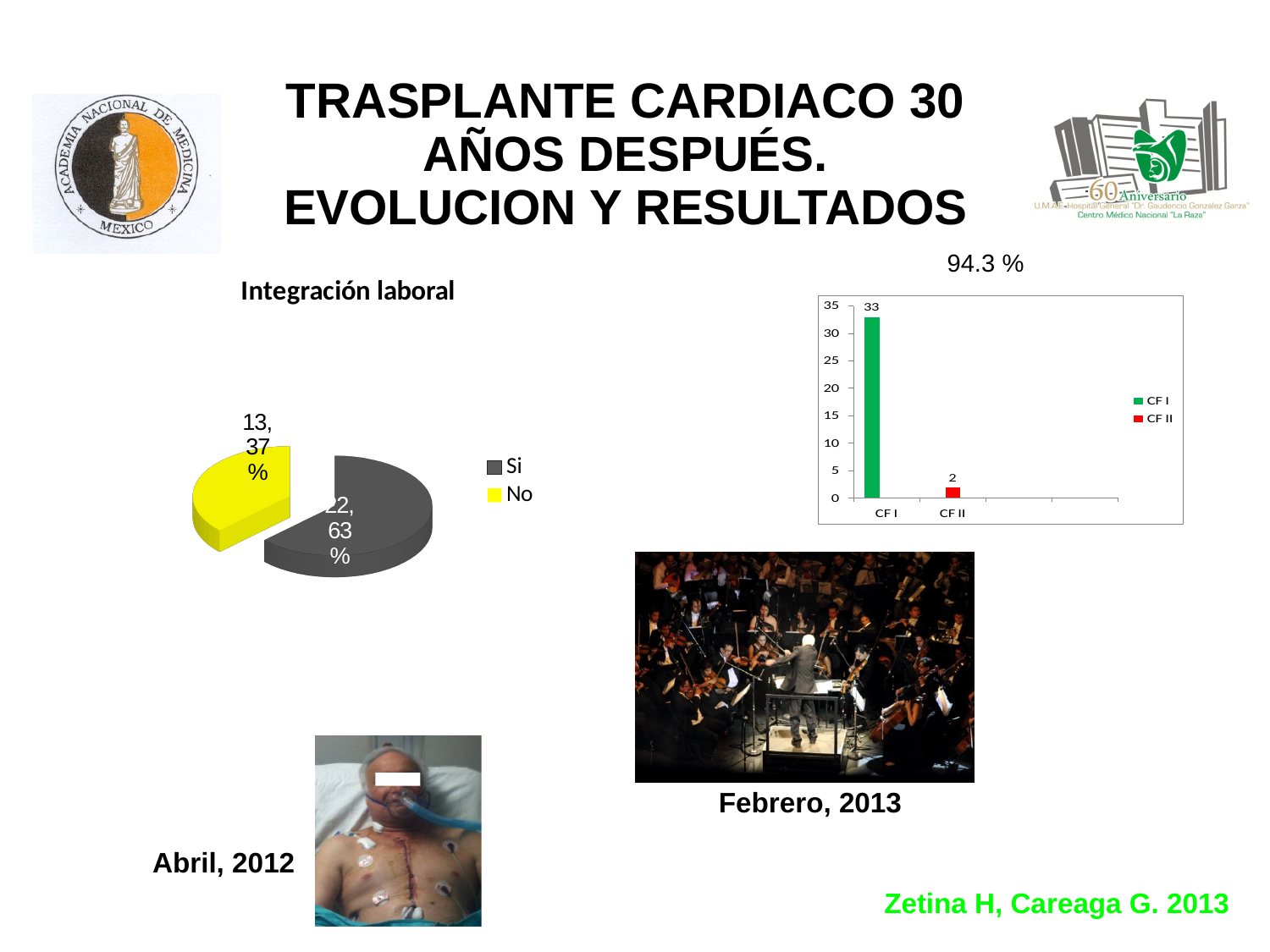
In the 'Integración laboral' pie chart, how many slices are there? 2 In the 'Integración laboral' pie chart, what count is shown for the 'No' slice? 13 In the bar chart on the right, what is the value for CF I? 33 In the 'Integración laboral' pie chart, what percentage is shown for 'No'? 37% In the 'Integración laboral' pie chart, which slice is larger, 'Si' or 'No'? Si What type of chart is the 'Integración laboral' chart? Pie chart In the 'Integración laboral' pie chart, what percentage is shown for 'Si'? 63% What type of chart is the chart on the right showing CF I and CF II? Bar chart In the bar chart on the right, what is the difference between the values for CF I and CF II? 31 In the bar chart on the right, how many series does the legend list? 2 In the 'Integración laboral' pie chart, what colour is the 'No' slice? Yellow In the bar chart on the right, what is the value for CF II? 2